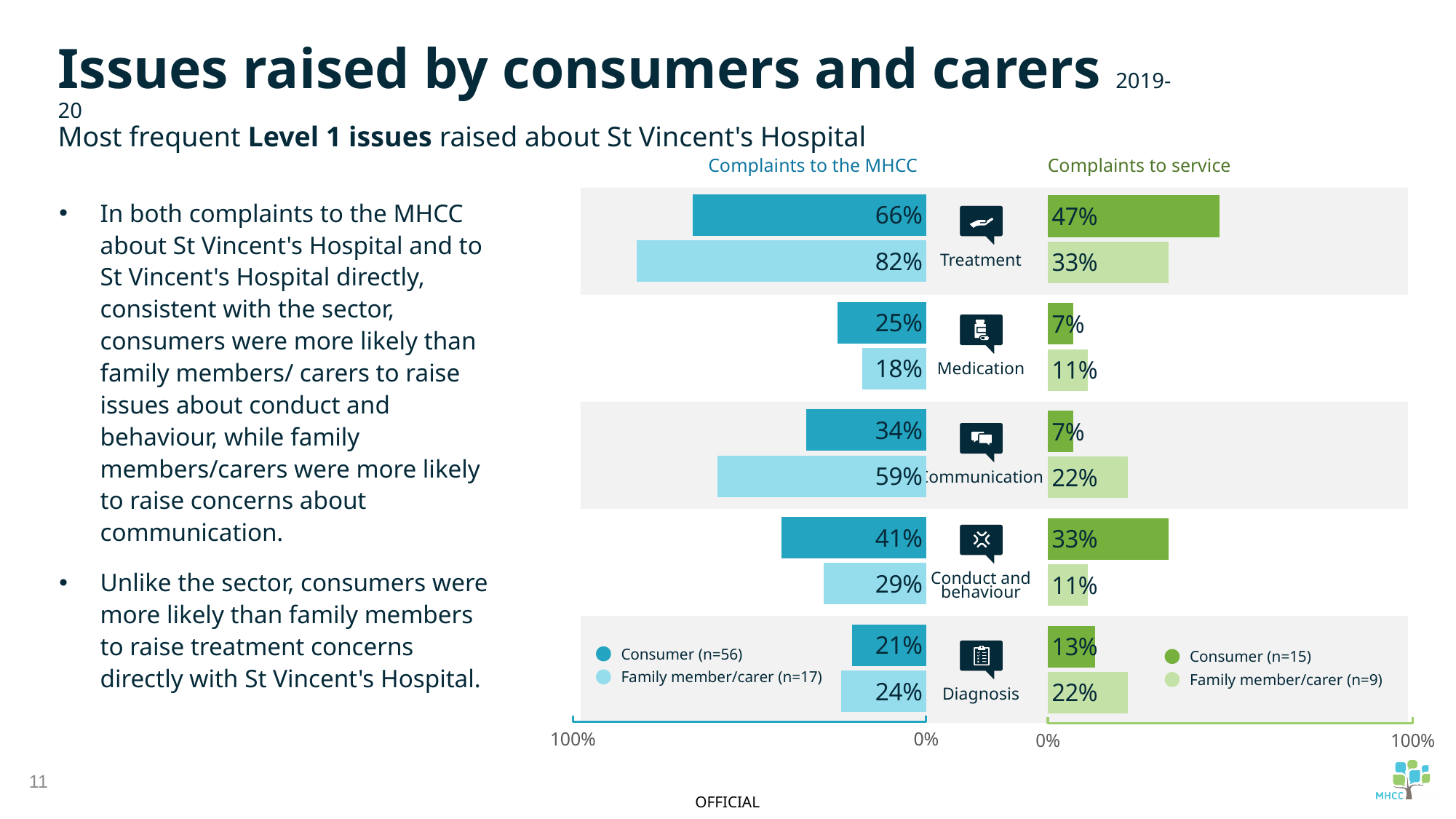
In the 'Complaints to the MHCC' chart, what is the difference between the family member/carer and consumer percentages for Treatment? 16% According to the legend of the 'Complaints to service' chart, what is the sample size (n) for consumers? 15 In the 'Complaints to service' chart, what percentage of family member/carer complaints were about Diagnosis? 22% In the 'Complaints to service' chart, which is larger for Communication: the consumer percentage or the family member/carer percentage? Family member/carer In the 'Complaints to the MHCC' chart, what percentage of consumer complaints were about Treatment? 66% In the 'Complaints to the MHCC' chart, which issue has the highest percentage for family member/carer? Treatment In the 'Complaints to the MHCC' chart, what percentage of family member/carer complaints were about Communication? 59% How many issue categories are shown in the 'Complaints to the MHCC' chart? 5 How many series does the legend of the 'Complaints to service' chart list? 2 In the 'Complaints to service' chart, what percentage of consumer complaints were about Conduct and behaviour? 33% In the 'Complaints to service' chart, which issue has the lowest percentage for family member/carer? Medication and Conduct and behaviour (both 11%) What type of chart is the 'Complaints to the MHCC' chart? Bar chart